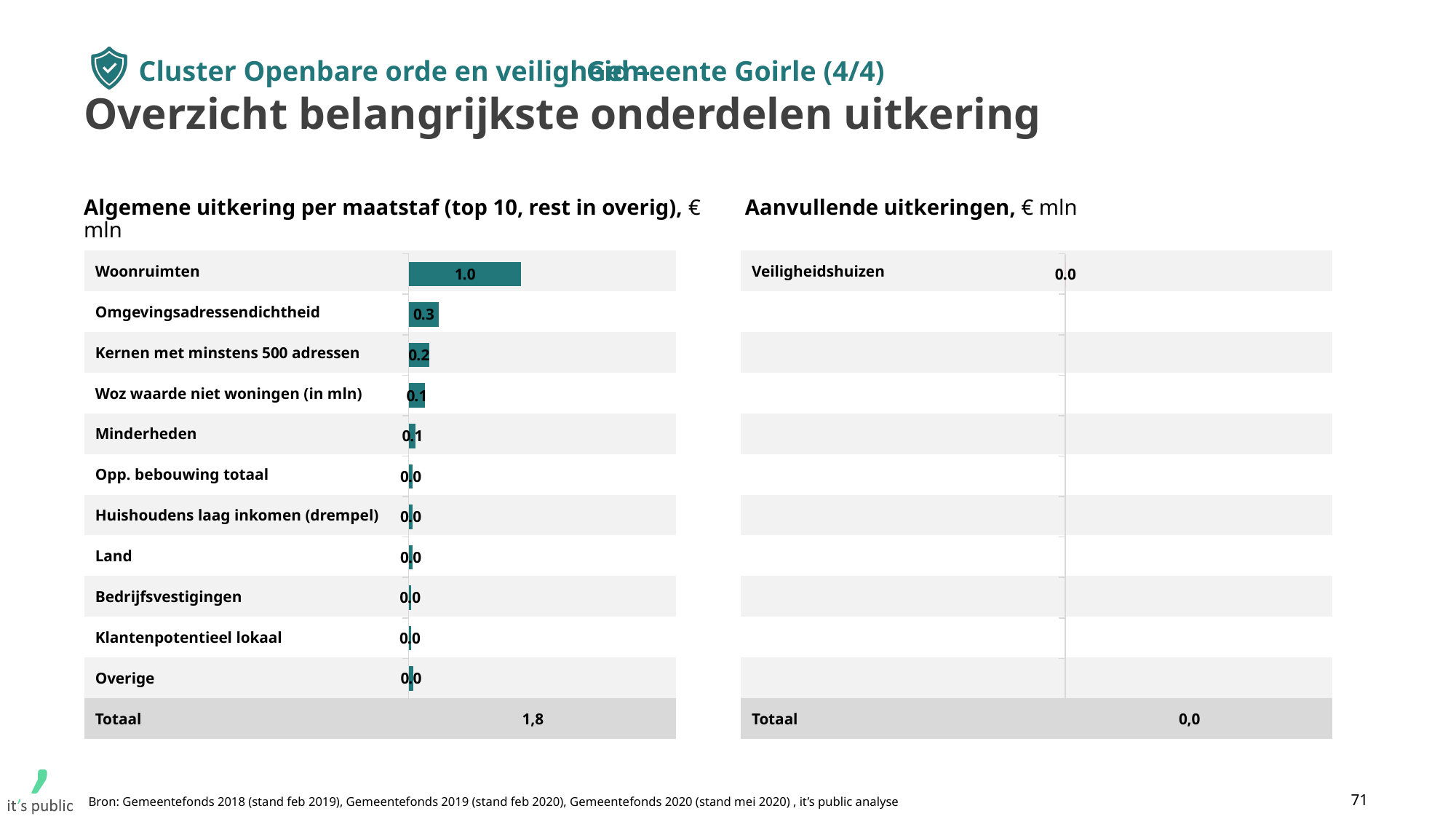
What is the Totaal shown for the 'Aanvullende uitkeringen' chart? 0,0 In the 'Algemene uitkering per maatstaf' chart, what is the value for Woonruimten? 1.0 In the 'Algemene uitkering per maatstaf' chart, which category has the highest value? Woonruimten What kind of chart is the 'Algemene uitkering per maatstaf' chart? Bar chart How many categories (excluding the Totaal row) are shown in the 'Algemene uitkering per maatstaf' chart? 11 In the 'Algemene uitkering per maatstaf' chart, what is the value for Omgevingsadressendichtheid? 0.3 In the 'Aanvullende uitkeringen' chart, what is the value for Veiligheidshuizen? 0.0 What is the Totaal shown for the 'Algemene uitkering per maatstaf' chart? 1,8 In the 'Algemene uitkering per maatstaf' chart, what is the difference between Woonruimten and Omgevingsadressendichtheid? 0.7 In the 'Algemene uitkering per maatstaf' chart, what is the value for Kernen met minstens 500 adressen? 0.2 In the 'Algemene uitkering per maatstaf' chart, which is larger: Omgevingsadressendichtheid or Kernen met minstens 500 adressen? Omgevingsadressendichtheid In what unit are the values in the 'Aanvullende uitkeringen' chart expressed? € mln